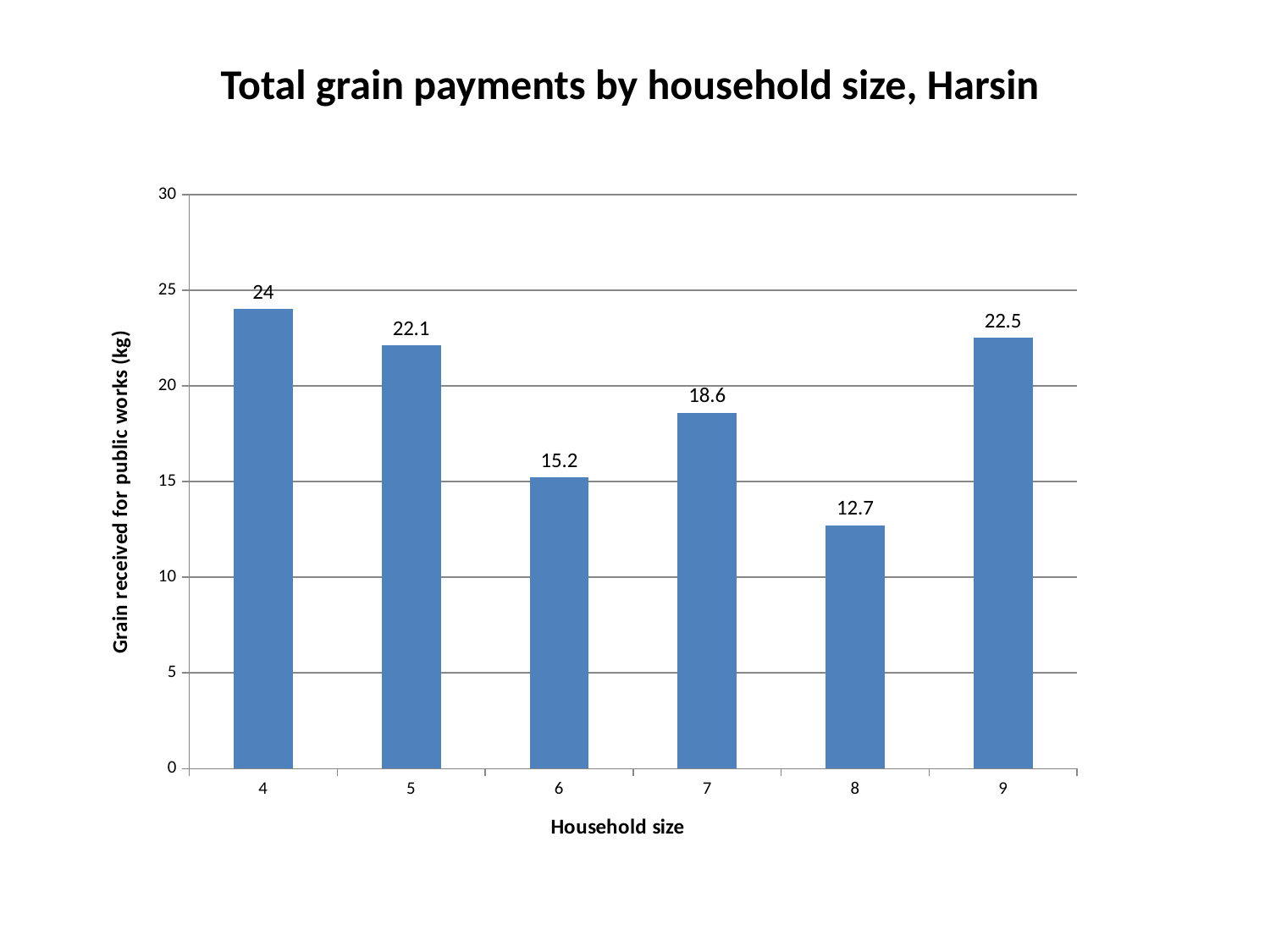
What is the difference between the grain received for household size 9 and household size 5? 0.4 How many household size categories are shown on the chart? 6 What is the difference between the grain received for household size 4 and household size 8? 11.3 What is the label of the y axis? Grain received for public works (kg) What is the grain received for household size 4? 24 Which household size has the highest grain payment? 4 What is the grain received for household size 8? 12.7 What is the grain received for household size 6? 15.2 Is the value for household size 7 greater or less than 20? less Which household size has the lowest grain payment? 8 Which has a larger grain payment, household size 7 or household size 6? Household size 7 What kind of chart is shown on the slide? Bar chart